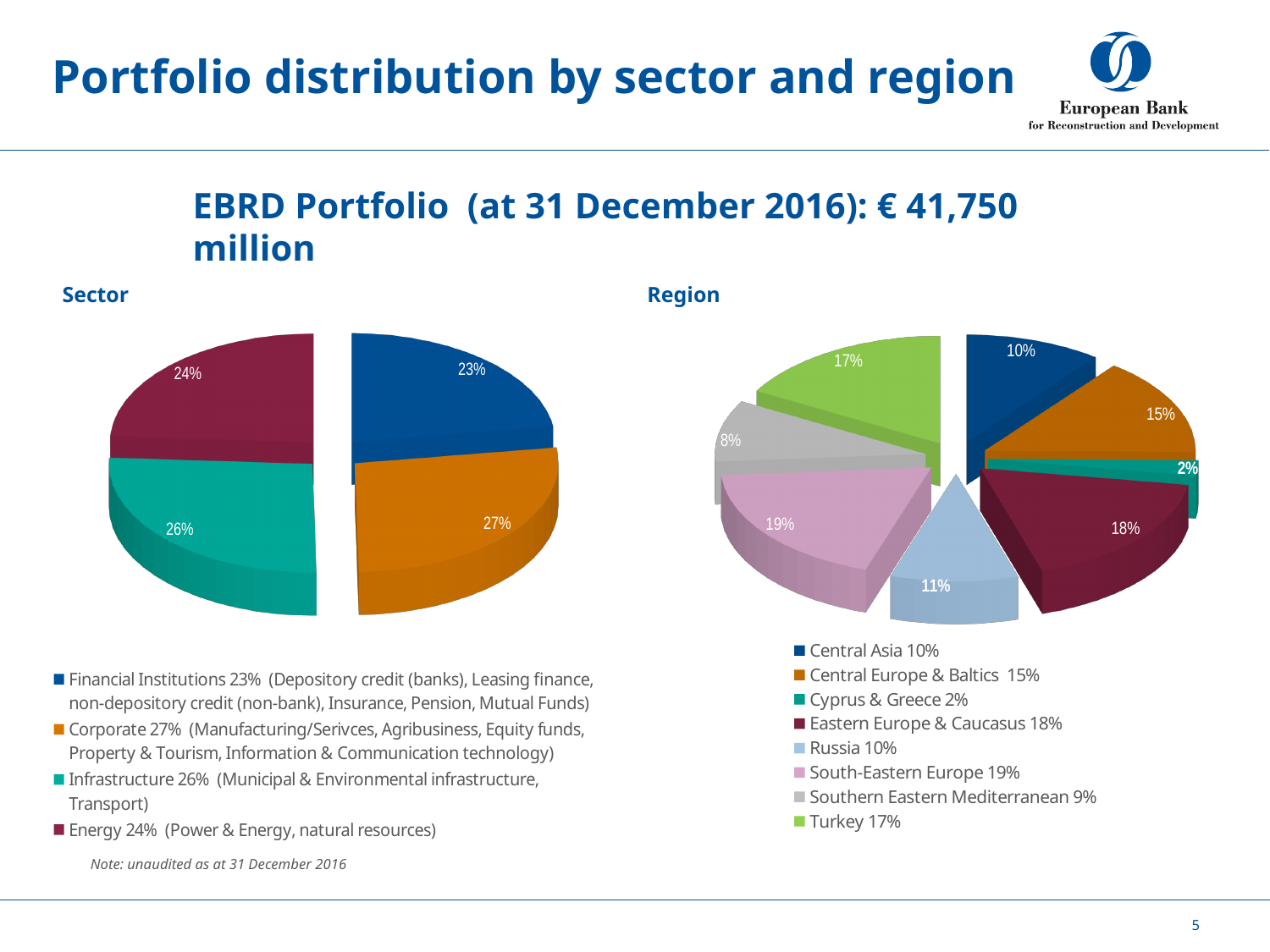
In the Region pie chart, which region has the smallest share? Cyprus & Greece How many sectors are shown in the Sector pie chart? 4 In the Sector pie chart, what share does Infrastructure have? 26% In the Region pie chart, what share does Turkey have? 17% In the Region pie chart, which is larger: Central Europe & Baltics or Central Asia? Central Europe & Baltics What type of charts are shown on the slide? Pie charts In the Sector pie chart, which sector has the largest share? Corporate In the Region pie chart, what share does Eastern Europe & Caucasus have? 18% In the Sector pie chart, what share does Corporate have? 27% How many regions are listed in the legend of the Region pie chart? 8 In the Sector pie chart, which sector has the smallest share? Financial Institutions In the Sector pie chart, what is the difference between the Corporate share and the Energy share? 3%